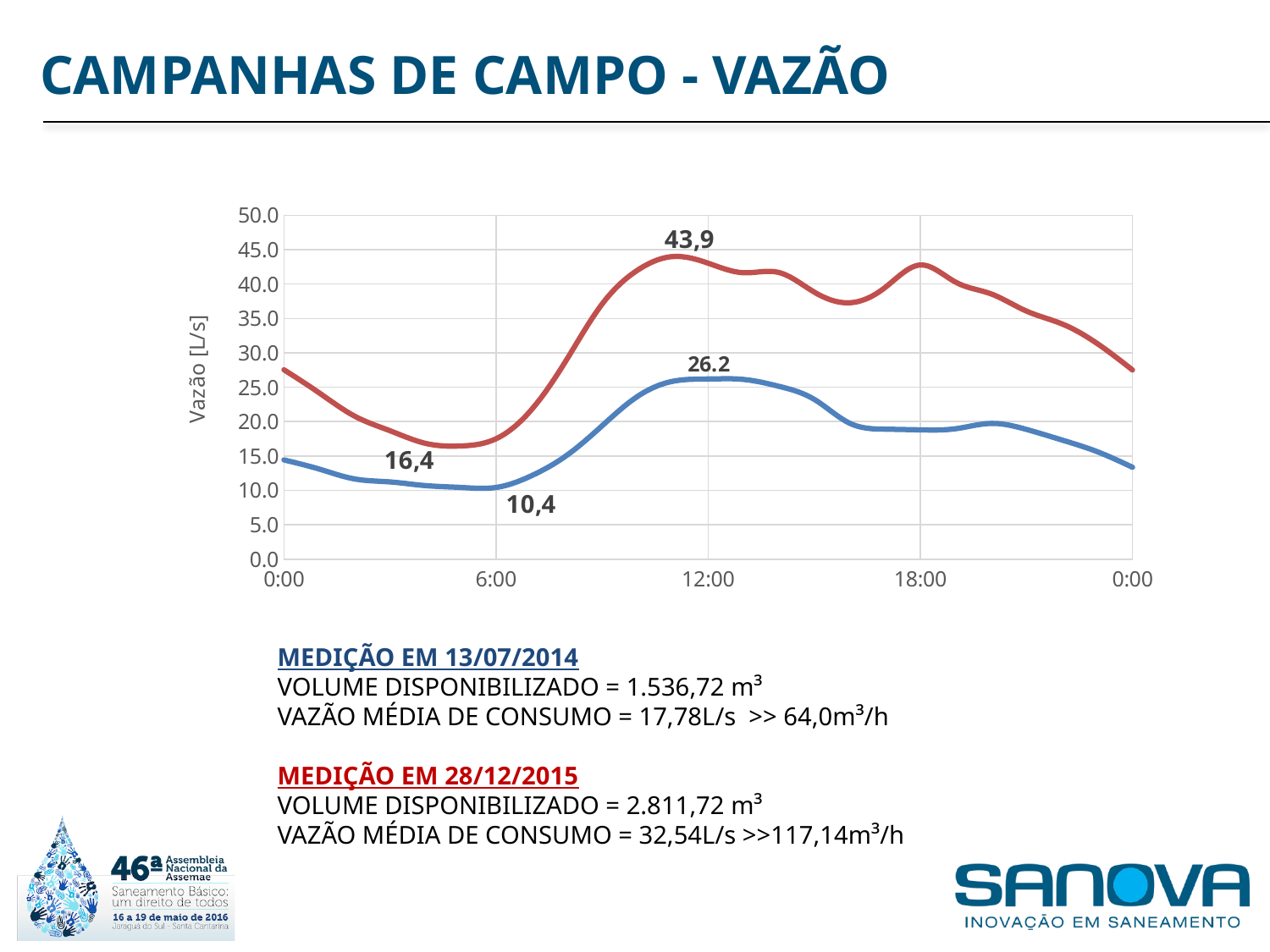
What is the lowest value labelled on the red line? 16,4 At 12:00, which line is higher, the red line or the blue line? red line What is the lowest value labelled on the blue line? 10,4 What is the peak value labelled on the red line? 43,9 What is the difference between the labelled peak (43,9) and the labelled minimum (16,4) of the red line? 27,5 What is the peak value labelled on the blue line? 26.2 Is the value of the blue line at 6:00 greater or less than 15.0? less What is the label on the vertical axis of the chart? Vazão [L/s] Is the value of the red line at 18:00 greater or less than 40.0? greater What kind of chart is shown on the slide? line chart How many lines are plotted on the chart? 2 Between 6:00 and 12:00, does the red line rise or fall? rise